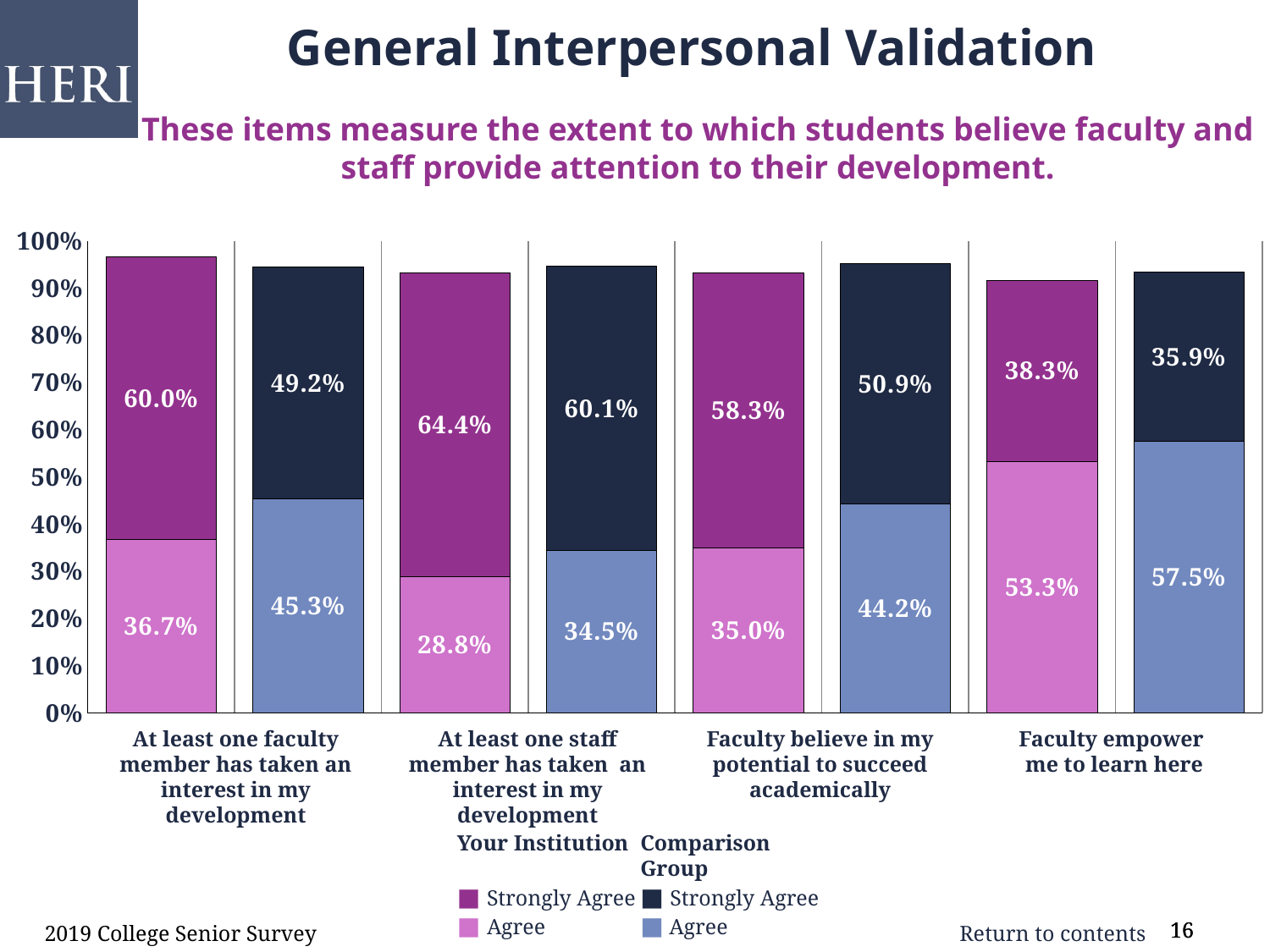
How many series does the chart legend list? 4 What percentage of students at Your Institution strongly agree that at least one faculty member has taken an interest in their development? 60.0% What is the combined Agree plus Strongly Agree total for the Your Institution bar for 'Faculty empower me to learn here'? 91.6% What is the combined Agree plus Strongly Agree total for the Comparison Group bar for 'At least one faculty member has taken an interest in my development'? 94.5% What is the Your Institution 'Agree' value for 'At least one staff member has taken an interest in my development'? 28.8% For 'Faculty believe in my potential to succeed academically', which is larger: the Your Institution 'Strongly Agree' value or the Comparison Group 'Strongly Agree' value? Your Institution (58.3%) Which item has the lowest Comparison Group 'Strongly Agree' percentage? Faculty empower me to learn here What type of chart is shown on the slide? Stacked bar chart What is the difference between the Your Institution and Comparison Group 'Strongly Agree' percentages for 'At least one faculty member has taken an interest in my development'? 10.8% Across the four items, which item has the highest Your Institution 'Strongly Agree' percentage? At least one staff member has taken an interest in my development What percentage of the Comparison Group agree (not strongly) that faculty empower them to learn here? 57.5% How many survey items (categories) are shown on the x axis of the chart? 4